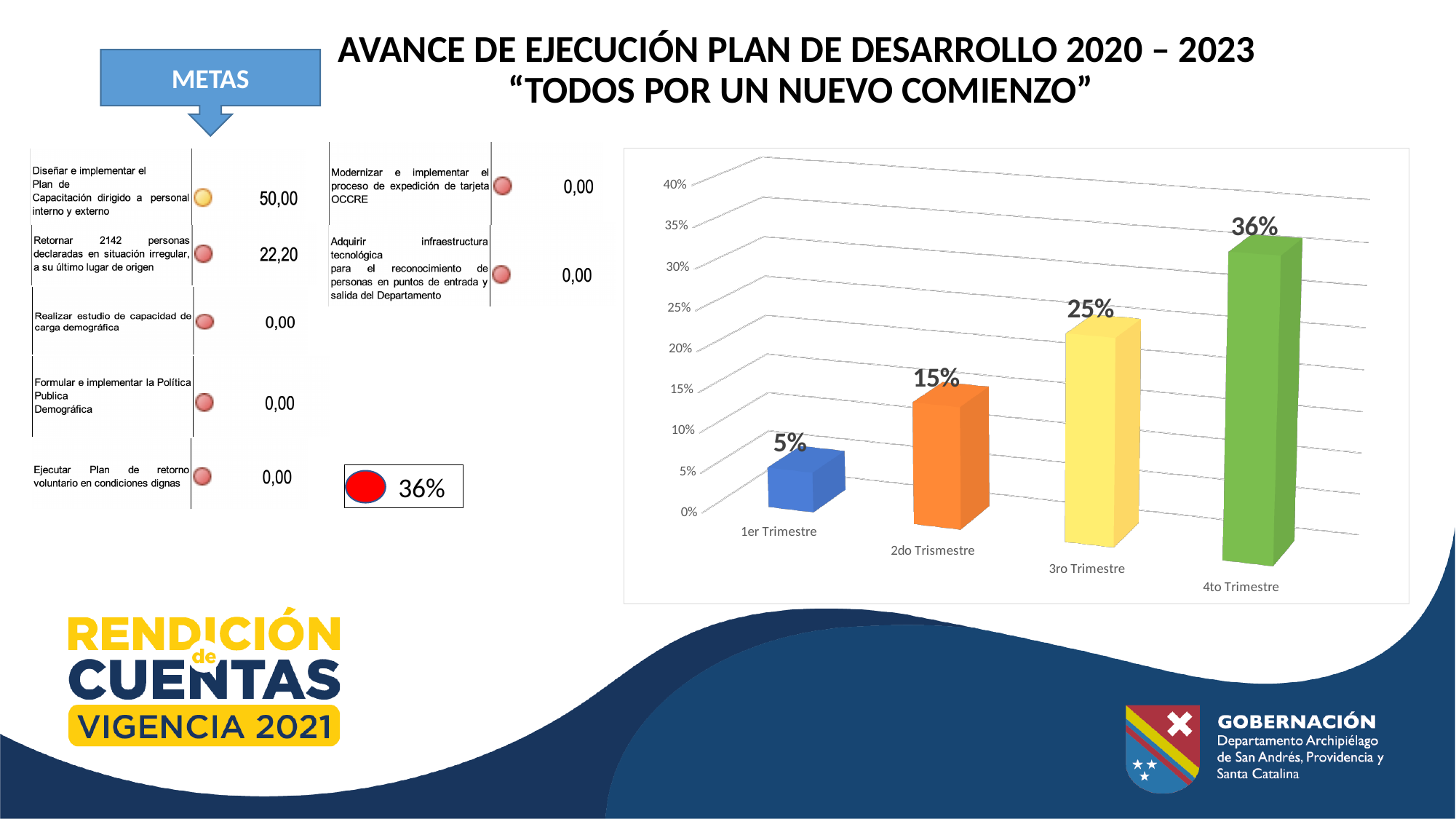
Which quarter has the highest value? 4to Trimestre What is the value for 1er Trimestre? 5% What is the difference between the values for 4to Trimestre and 3ro Trimestre? 11% What is the value for 4to Trimestre? 36% What is the difference between the values for 2do Trismestre and 1er Trimestre? 10% What is the value for 2do Trismestre? 15% What kind of chart is shown on the slide? Bar chart Which is larger, the value for 2do Trismestre or 3ro Trimestre? 3ro Trimestre What is the value for 3ro Trimestre? 25% Which quarter has the lowest value? 1er Trimestre Do the values rise or fall from 1er Trimestre to 4to Trimestre? Rise How many categories are shown on the x axis of the chart? 4